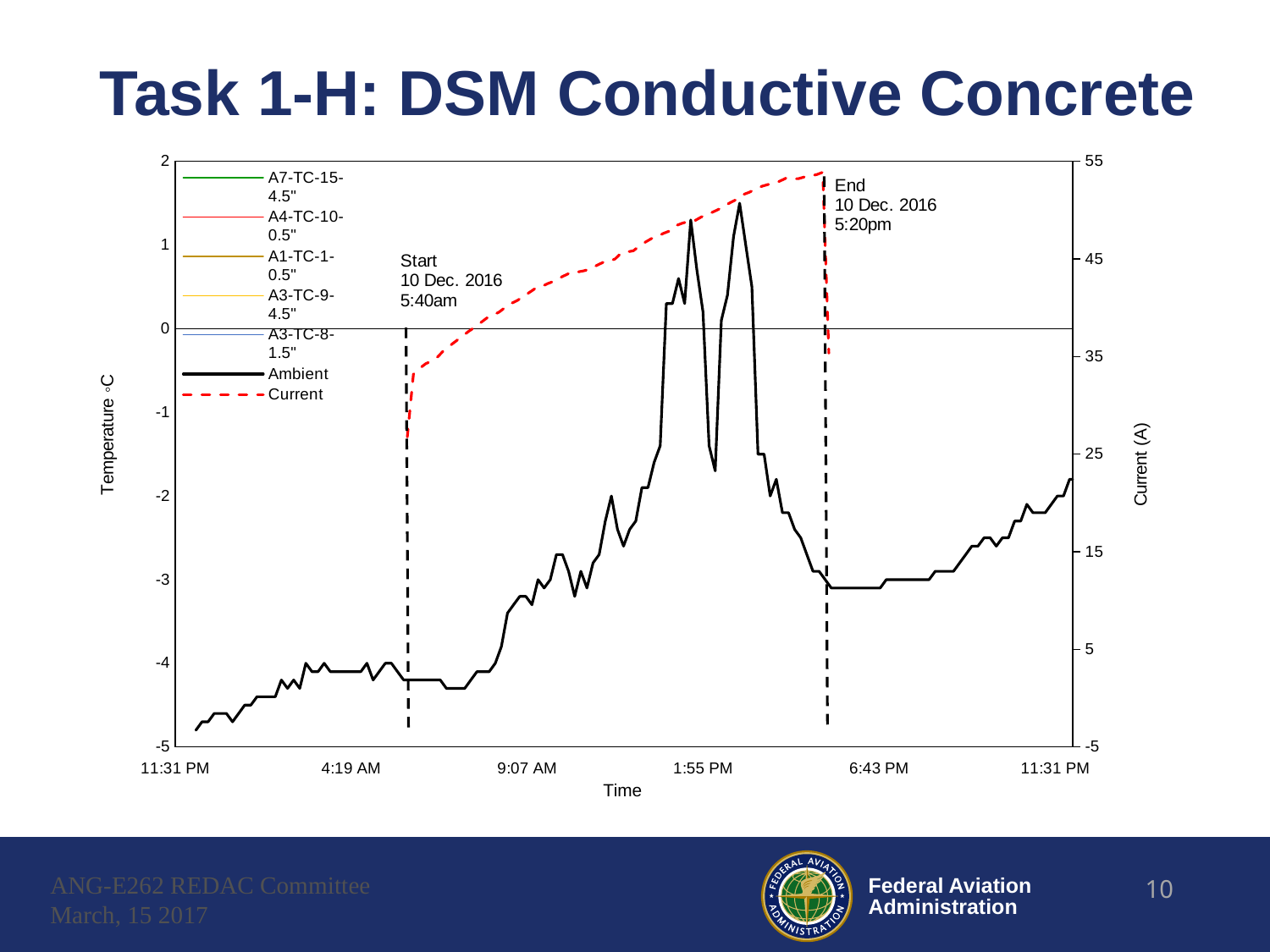
How many series does the legend list? 7 Is the Ambient temperature at 11:31 PM (left end of the x axis) greater or less than -4? less What date and time does the 'Start' annotation on the chart give? 10 Dec. 2016 5:40am Does the Current series rise or fall between the Start and End markers? rise Is the Current value at the 'End' marker greater or less than 45? greater What is the label of the right-hand vertical axis? Current (A) What kind of chart is shown on the slide? line chart How many time labels are shown along the x axis? 6 What is the title of the slide containing the chart? Task 1-H: DSM Conductive Concrete What is the highest tick value shown on the right-hand Current (A) axis? 55 What is the lowest tick value shown on the left-hand Temperature axis? -5